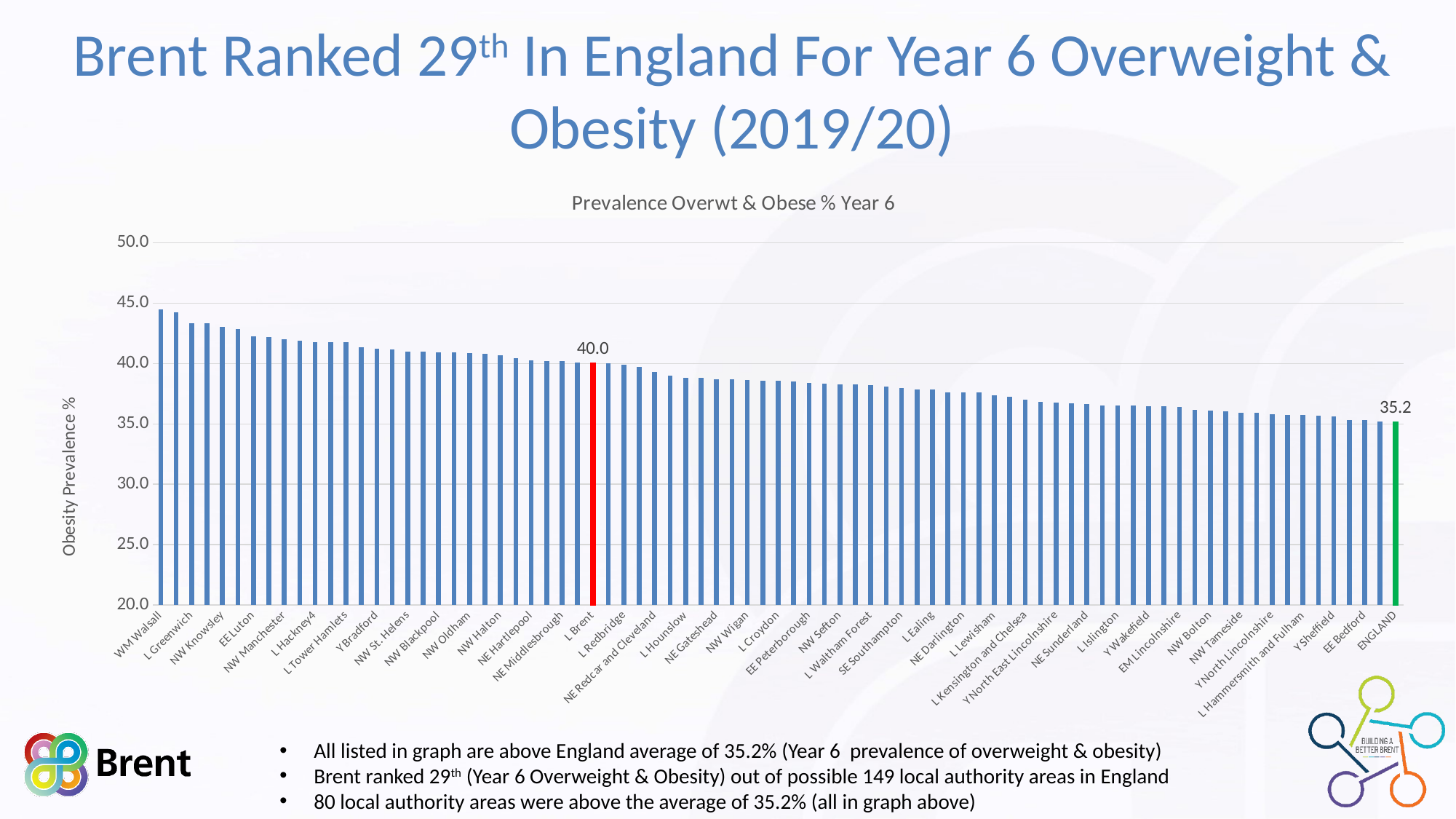
What colour is the bar for L Brent? red What is the title of the chart? Prevalence Overwt & Obese % Year 6 Is the value for NE Gateshead greater or less than 40.0? less Which category has the lowest bar in the chart? ENGLAND What is the value shown for ENGLAND? 35.2 Which has the larger value, EE Luton or L Brent? EE Luton What is the difference between the value for L Brent and the value for ENGLAND? 4.8 What is the Year 6 overweight & obese prevalence value shown for L Brent? 40.0 Do the bar values rise or fall moving from left to right along the x axis? fall Which category has the highest bar in the chart? WM Walsall What kind of chart is shown on the slide? bar chart Is the value for WM Walsall greater or less than 40.0? greater